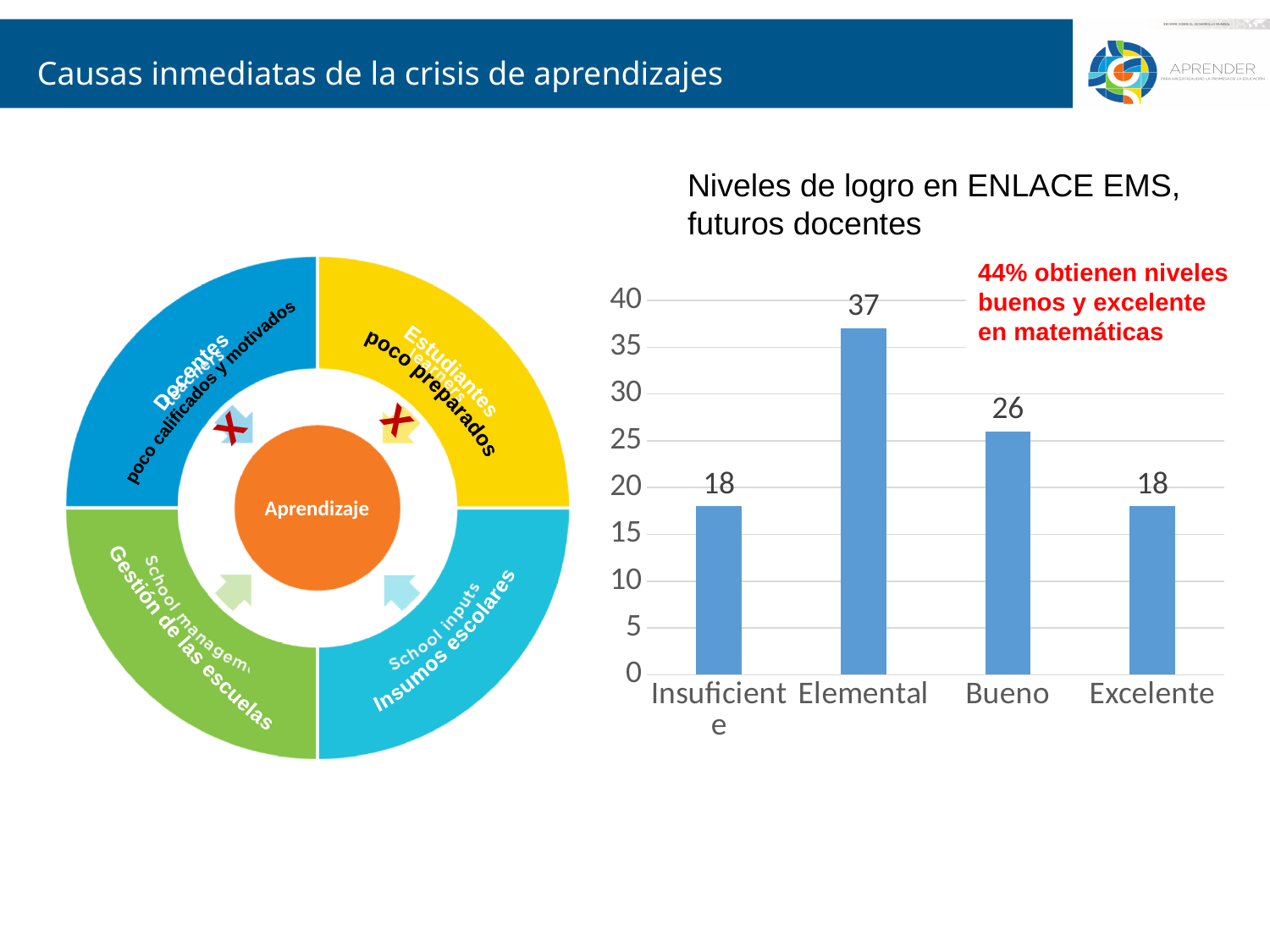
What is the value for Excelente in the chart? 18 What is the difference between the values for Bueno and Excelente? 8 What is the value for Insuficiente in the chart? 18 Is the value for Elemental greater or less than 35? greater What is the title of the chart? Niveles de logro en ENLACE EMS, futuros docentes What is the value for Bueno in the chart? 26 What is the value for Elemental in the chart? 37 What kind of chart is shown on the slide? bar chart Which category has the highest value in the chart? Elemental What is the difference between the values for Elemental and Bueno? 11 How many categories are shown on the x axis of the chart? 4 Which is larger, the value for Bueno or the value for Excelente? Bueno